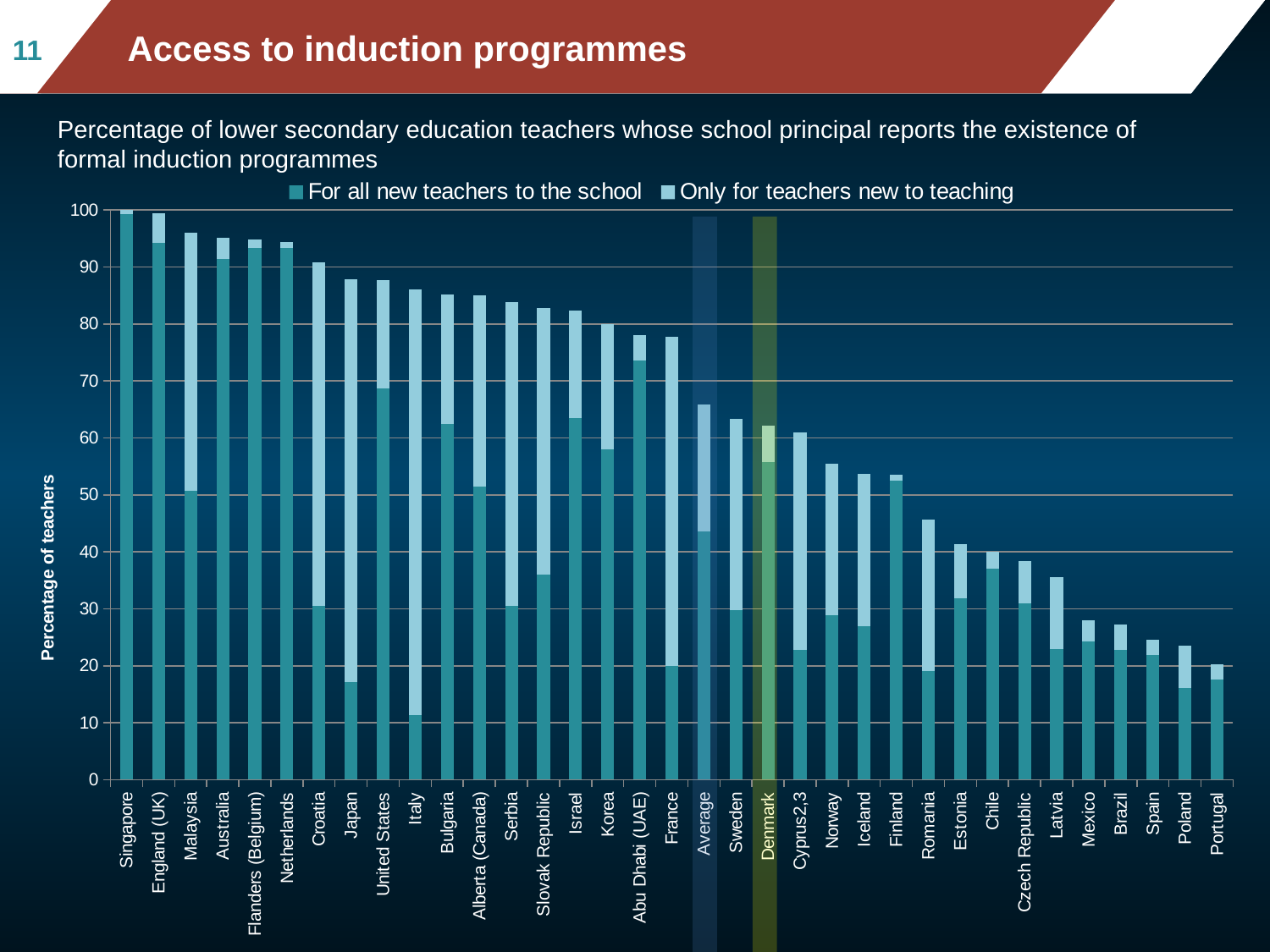
How many countries or regions (including Average) are shown on the x axis? 35 Is the total value for Average greater or less than 60? greater Which category has the highest total percentage of teachers? Singapore Is the total value for Romania greater or less than 50? less Is the total value for Mexico greater or less than 30? less What is the title of the y axis? Percentage of teachers What kind of chart is shown on the slide? Stacked bar chart How many series does the legend list? 2 Which has a larger total value, Bulgaria or France? Bulgaria Do the total values generally rise or fall from left to right along the x axis? Fall Which category has the lowest total percentage of teachers? Portugal